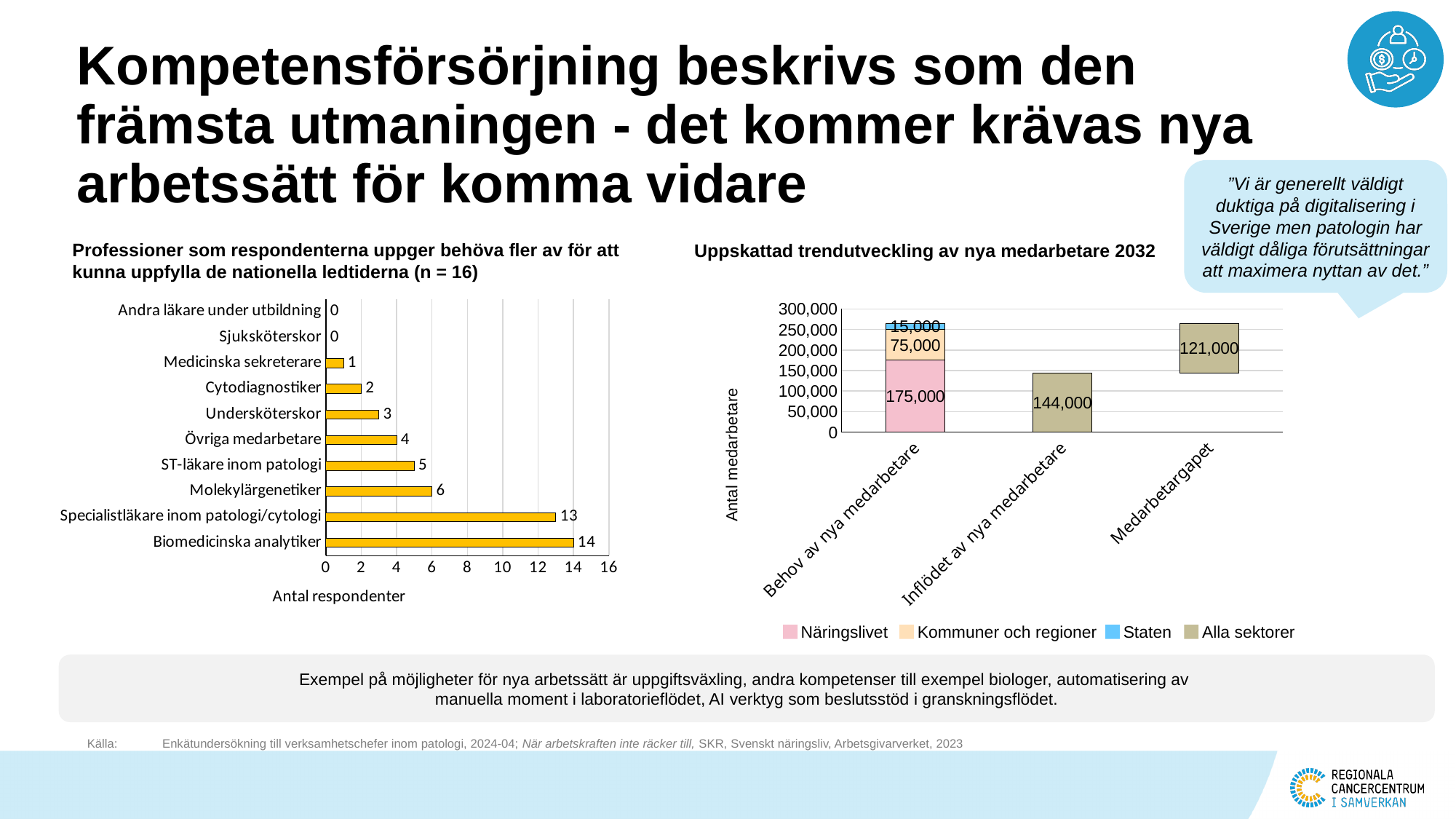
In the left chart (Professioner som respondenterna uppger behöva fler av), what is the value for Biomedicinska analytiker? 14 In the right chart (Uppskattad trendutveckling av nya medarbetare 2032), what is the value for Näringslivet in Behov av nya medarbetare? 175,000 What type of chart is the left chart (Professioner som respondenterna uppger behöva fler av)? Bar chart In the left chart (Professioner som respondenterna uppger behöva fler av), how many professions are listed? 10 In the left chart (Professioner som respondenterna uppger behöva fler av), what is the difference between Specialistläkare inom patologi/cytologi and Molekylärgenetiker? 7 In the left chart (Professioner som respondenterna uppger behöva fler av), which is larger: Undersköterskor or Cytodiagnostiker? Undersköterskor In the left chart (Professioner som respondenterna uppger behöva fler av), what is the value for ST-läkare inom patologi? 5 In the left chart (Professioner som respondenterna uppger behöva fler av), which profession has the highest value? Biomedicinska analytiker In the right chart (Uppskattad trendutveckling av nya medarbetare 2032), how many series does the legend list? 4 In the right chart (Uppskattad trendutveckling av nya medarbetare 2032), what is the total of the stacked bar for Behov av nya medarbetare? 265,000 In the right chart (Uppskattad trendutveckling av nya medarbetare 2032), what is the label of the y axis? Antal medarbetare In the right chart (Uppskattad trendutveckling av nya medarbetare 2032), what is the difference between Inflödet av nya medarbetare and Medarbetargapet? 23,000